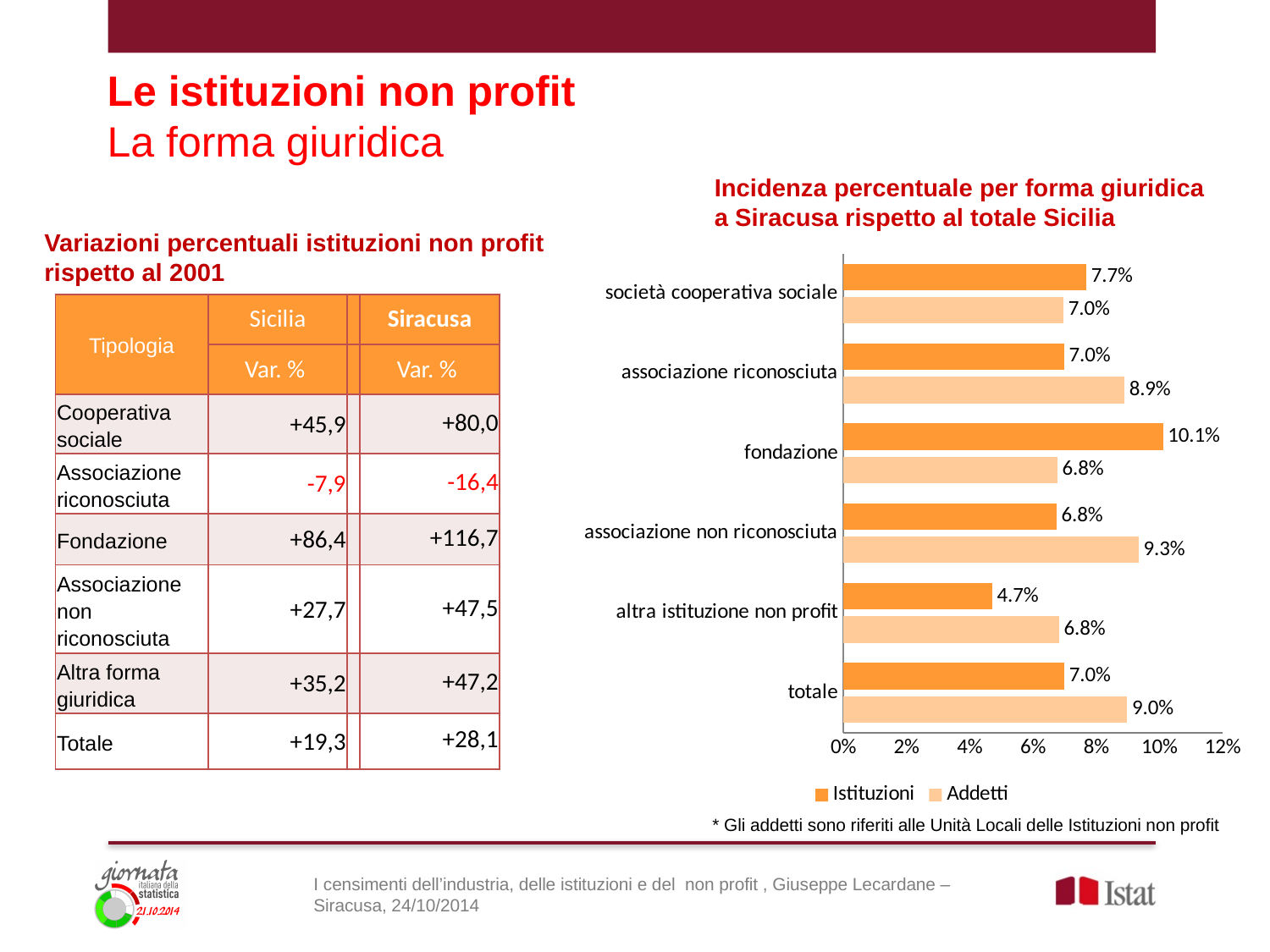
Which category has the highest Addetti value? associazione non riconosciuta What is the difference between the Istituzioni and Addetti values for fondazione? 3.3% What is the Istituzioni value for altra istituzione non profit? 4.7% What kind of chart is shown on the slide? bar chart Which category has the highest Istituzioni value? fondazione How many series does the chart legend list? 2 What is the Istituzioni value for fondazione? 10.1% Which category has the lowest Istituzioni value? altra istituzione non profit For associazione riconosciuta, which is larger: Istituzioni or Addetti? Addetti What is the Addetti value for totale? 9.0% What is the Addetti value for associazione non riconosciuta? 9.3% How many categories are shown on the chart? 6